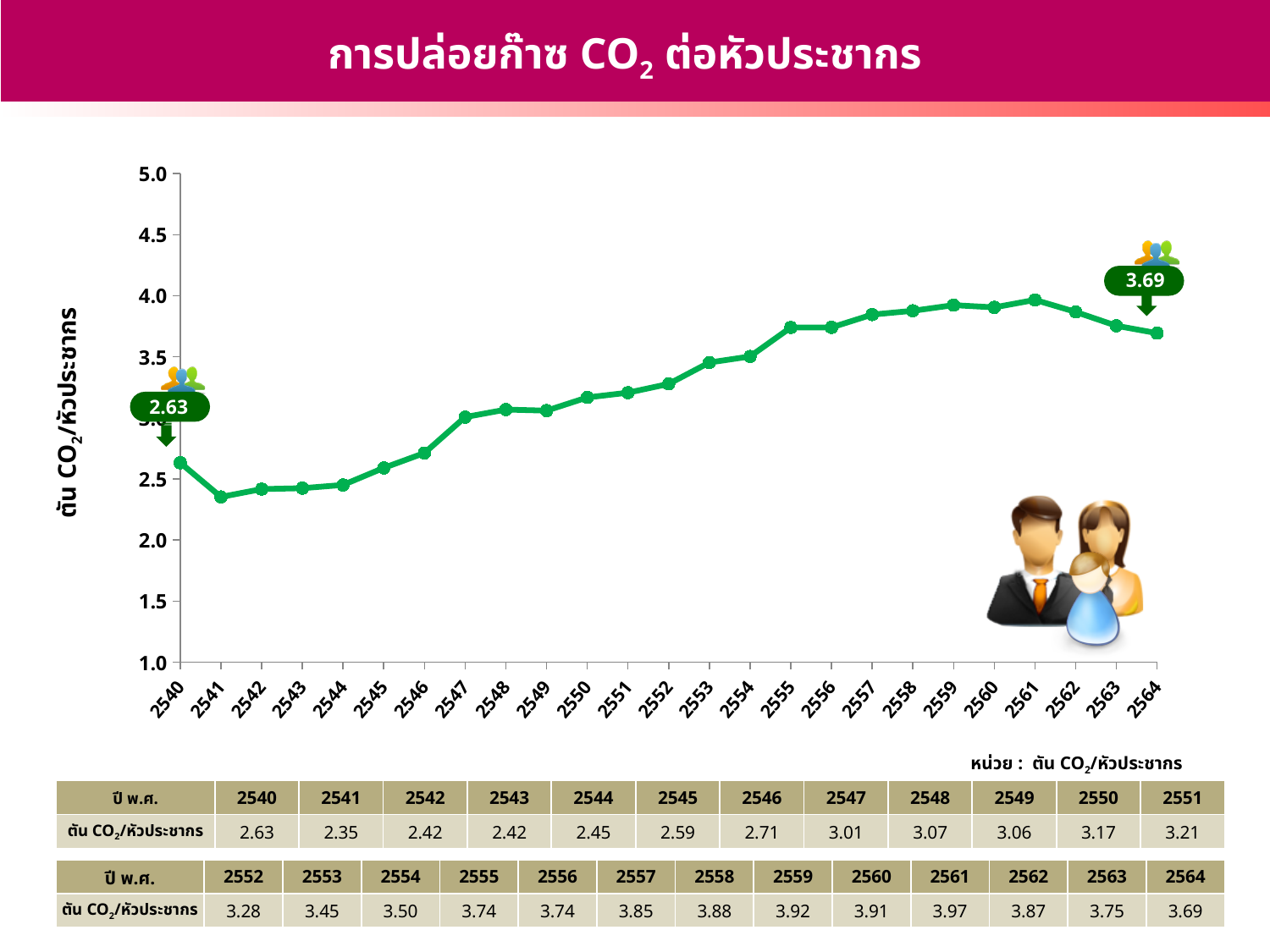
Which year has the highest CO2 emission per capita? 2561 What is the difference between the values for 2564 and 2540? 1.06 What is the difference between the highest value (2561) and the lowest value (2541)? 1.62 What is the value plotted for the year 2550? 3.17 What is the CO2 emission per capita value for the year 2564? 3.69 Is the value for 2555 greater or less than 3.5? greater What is the CO2 emission per capita value for the year 2540? 2.63 What kind of chart is shown on the slide? line chart Which year has the lowest CO2 emission per capita? 2541 Which year has the larger value, 2546 or 2547? 2547 Does the value generally rise or fall from 2541 to 2561? rise How many years (data points) are plotted on the chart? 25